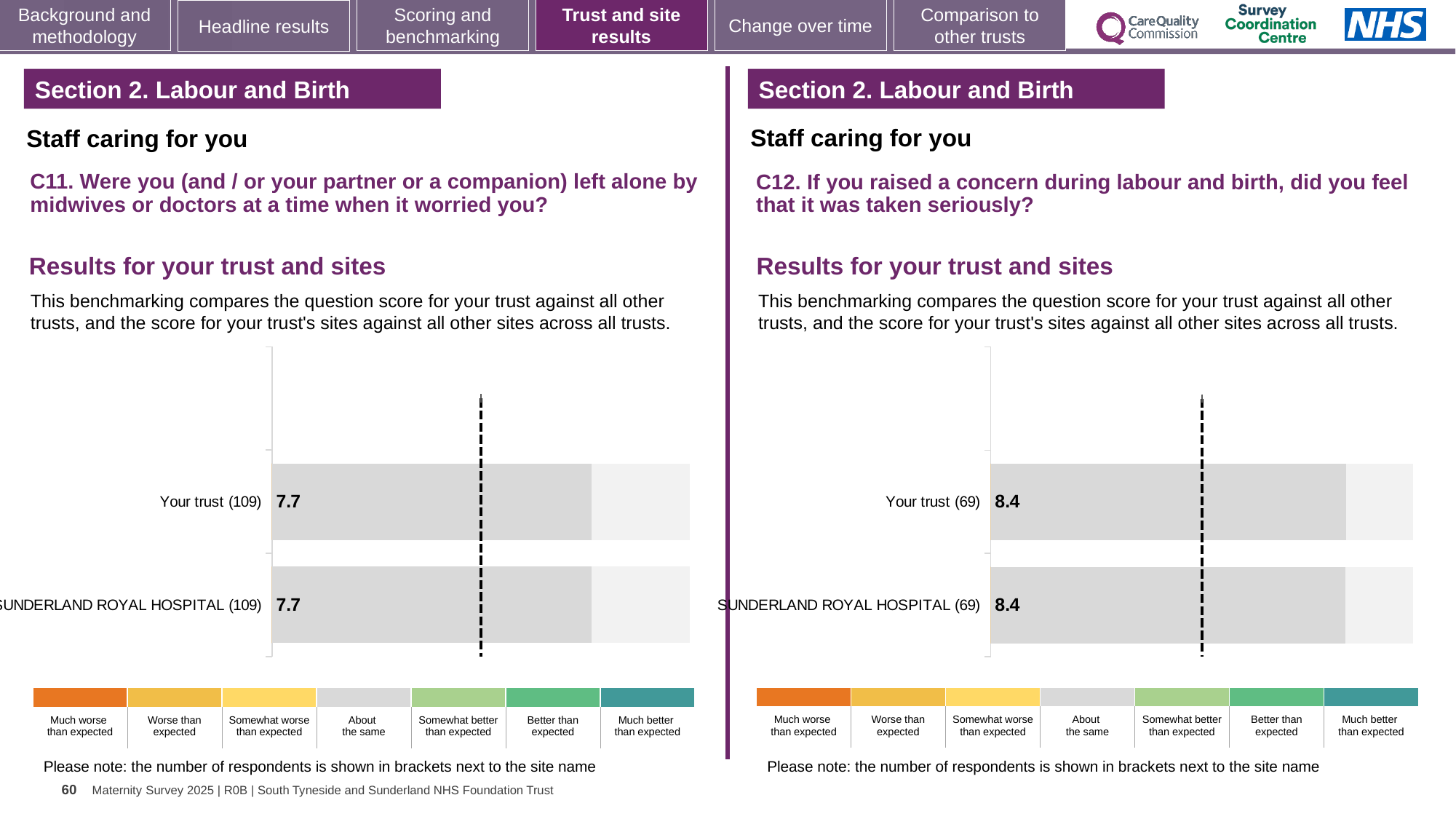
In the left chart (C11), what is the difference between the Your trust score and the SUNDERLAND ROYAL HOSPITAL score? 0 In the right chart (C12), what is the score for SUNDERLAND ROYAL HOSPITAL? 8.4 In the right chart (C12), what is the score for Your trust? 8.4 How many bars are plotted in the right chart (C12)? 2 In the right chart (C12), how many respondents are shown in brackets for SUNDERLAND ROYAL HOSPITAL? 69 How many bars are plotted in the left chart (C11)? 2 In the left chart (C11), what is the score for Your trust? 7.7 In the left chart (C11), what is the score for SUNDERLAND ROYAL HOSPITAL? 7.7 In the left chart (C11), how many respondents are shown in brackets for Your trust? 109 In the right chart (C12), what is the difference between the Your trust score and the SUNDERLAND ROYAL HOSPITAL score? 0 How many categories does the colour key below the right chart (C12) list? 7 What kind of chart is used in the left chart (C11)? Bar chart